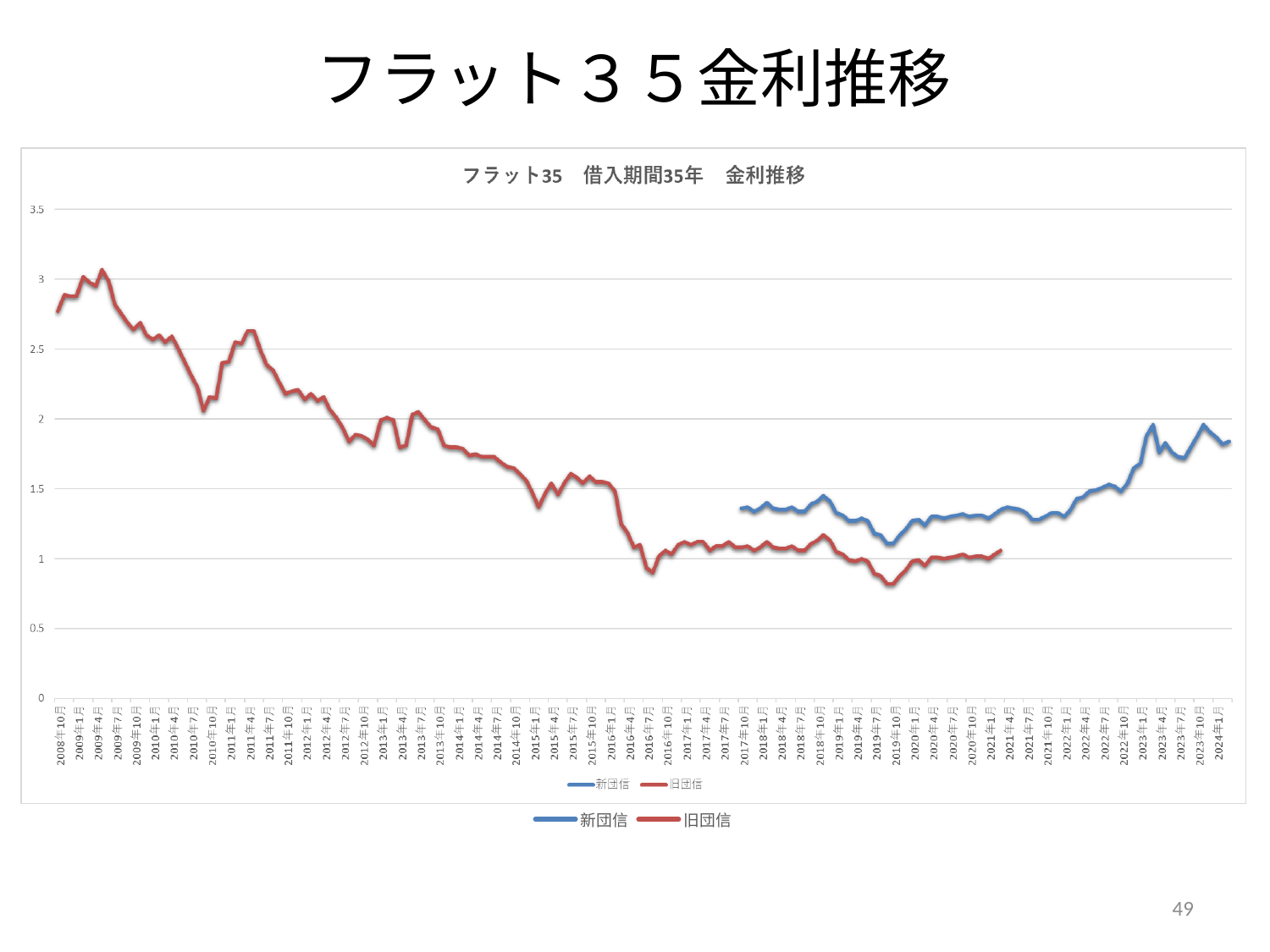
At 2018年1月, which series has the higher value, 新団信 or 旧団信? 新団信 Is the value of 旧団信 at 2009年4月 greater or less than 2.5? greater What colour is the 新団信 line? blue Is the value of 旧団信 at 2019年10月 greater or less than 1? less How many series does the legend list? 2 Is the value of 新団信 at 2023年1月 greater or less than 1.5? greater What are the two series named in the legend? 新団信 and 旧団信 What kind of chart is shown on the slide? line chart Does the 新団信 line generally rise or fall from 2020年1月 to 2024年1月? rise Does the 旧団信 line generally rise or fall from 2008年10月 to 2016年7月? fall Which series reaches the highest value anywhere on the chart? 旧団信